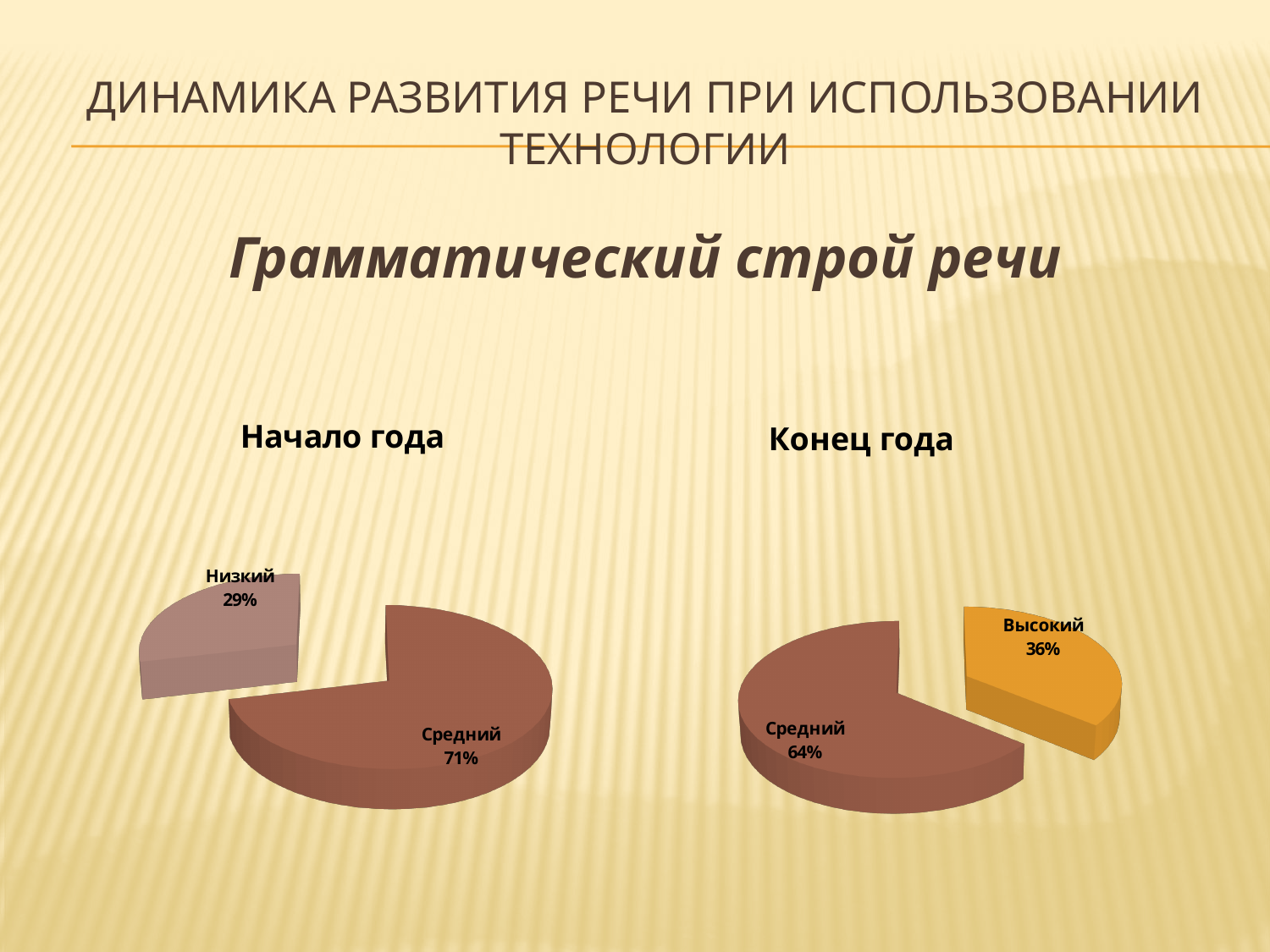
In the "Начало года" chart, what share does "Низкий" have? 29% In the "Конец года" chart, what share does "Высокий" have? 36% In the "Начало года" chart, which category has the largest slice? Средний What colour is the "Высокий" slice in the "Конец года" chart? Orange How many slices does the "Конец года" chart have? 2 In the "Конец года" chart, what is the difference between the "Средний" and "Высокий" shares? 28% Which is larger: "Средний" in the "Начало года" chart or "Средний" in the "Конец года" chart? Средний in Начало года In the "Конец года" chart, which category has the smallest slice? Высокий In the "Начало года" chart, what share does "Средний" have? 71% In the "Конец года" chart, what share does "Средний" have? 64% In the "Начало года" chart, what is the difference between the "Средний" and "Низкий" shares? 42% What type of chart is the "Начало года" chart? Pie chart